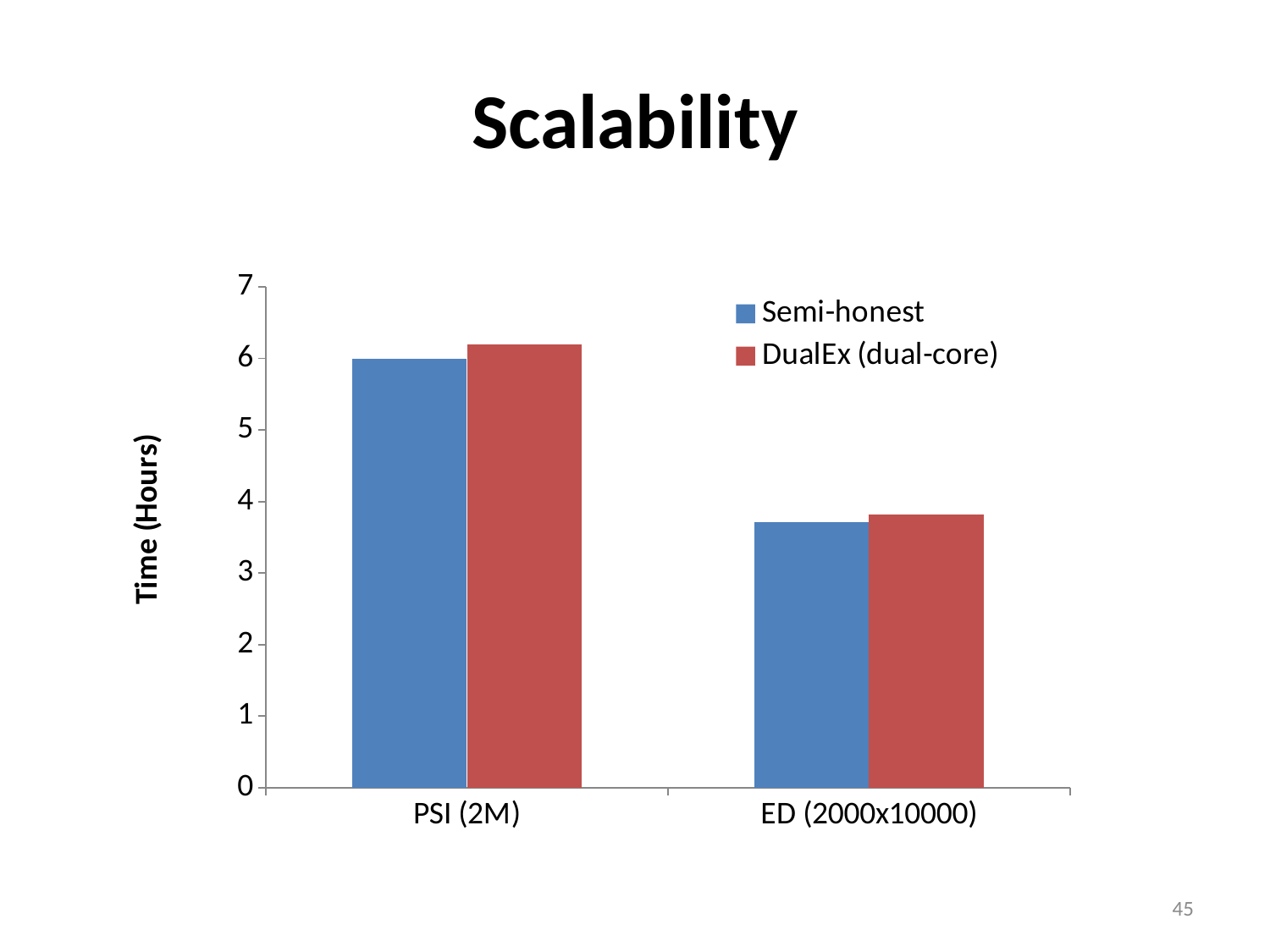
Is the DualEx (dual-core) value for PSI (2M) greater or less than 6? greater How many series does the chart's legend list? 2 Which bar in the chart is the tallest? DualEx (dual-core) for PSI (2M) Is the DualEx (dual-core) value for ED (2000x10000) greater or less than 3? greater Is the Semi-honest value for PSI (2M) greater or less than 5? greater How many categories are shown on the x axis of the chart? 2 For the Semi-honest series, which category has the larger value: PSI (2M) or ED (2000x10000)? PSI (2M) Which series is shown in red in the chart? DualEx (dual-core) What is the title of the chart's vertical axis? Time (Hours) Which bar in the chart is the shortest? Semi-honest for ED (2000x10000) What kind of chart is shown on the slide? bar chart